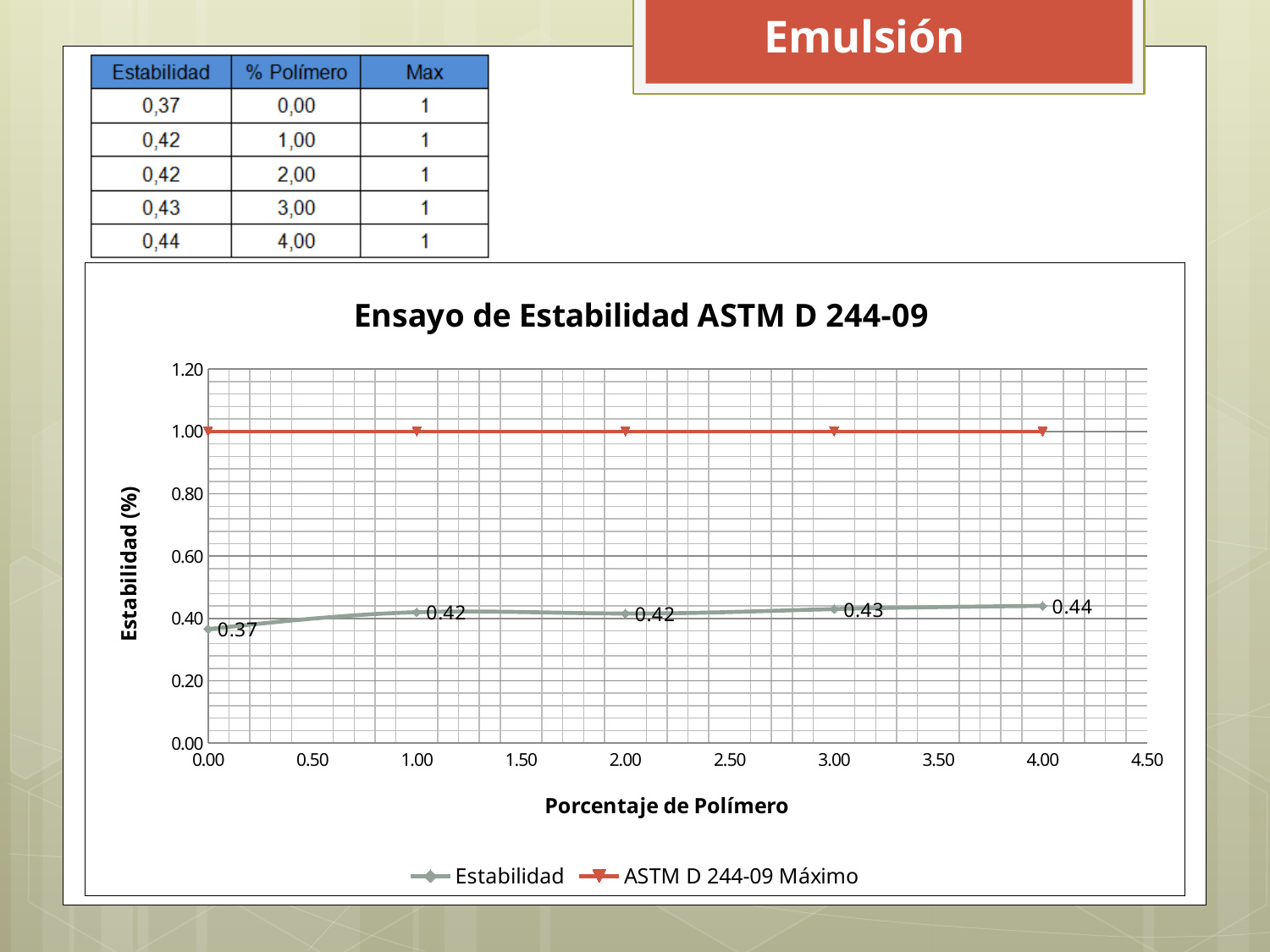
At which polymer percentage is the Estabilidad value highest? 4.00 How many series does the chart legend list? 2 Does the Estabilidad series generally rise or fall as the polymer percentage increases? rise What is the difference between the Estabilidad values at 4.00 and 0.00 percent polymer? 0.07 What is the title of the chart? Ensayo de Estabilidad ASTM D 244-09 At which polymer percentage is the Estabilidad value lowest? 0.00 What is the Estabilidad value at 4.00 percent polymer? 0.44 How many data points are plotted for the Estabilidad series? 5 What type of chart is shown on the slide? line chart What is the Estabilidad value at 3.00 percent polymer? 0.43 What is the Estabilidad value at 0.00 percent polymer? 0.37 Is the ASTM D 244-09 Máximo line greater or less than 0.80? greater